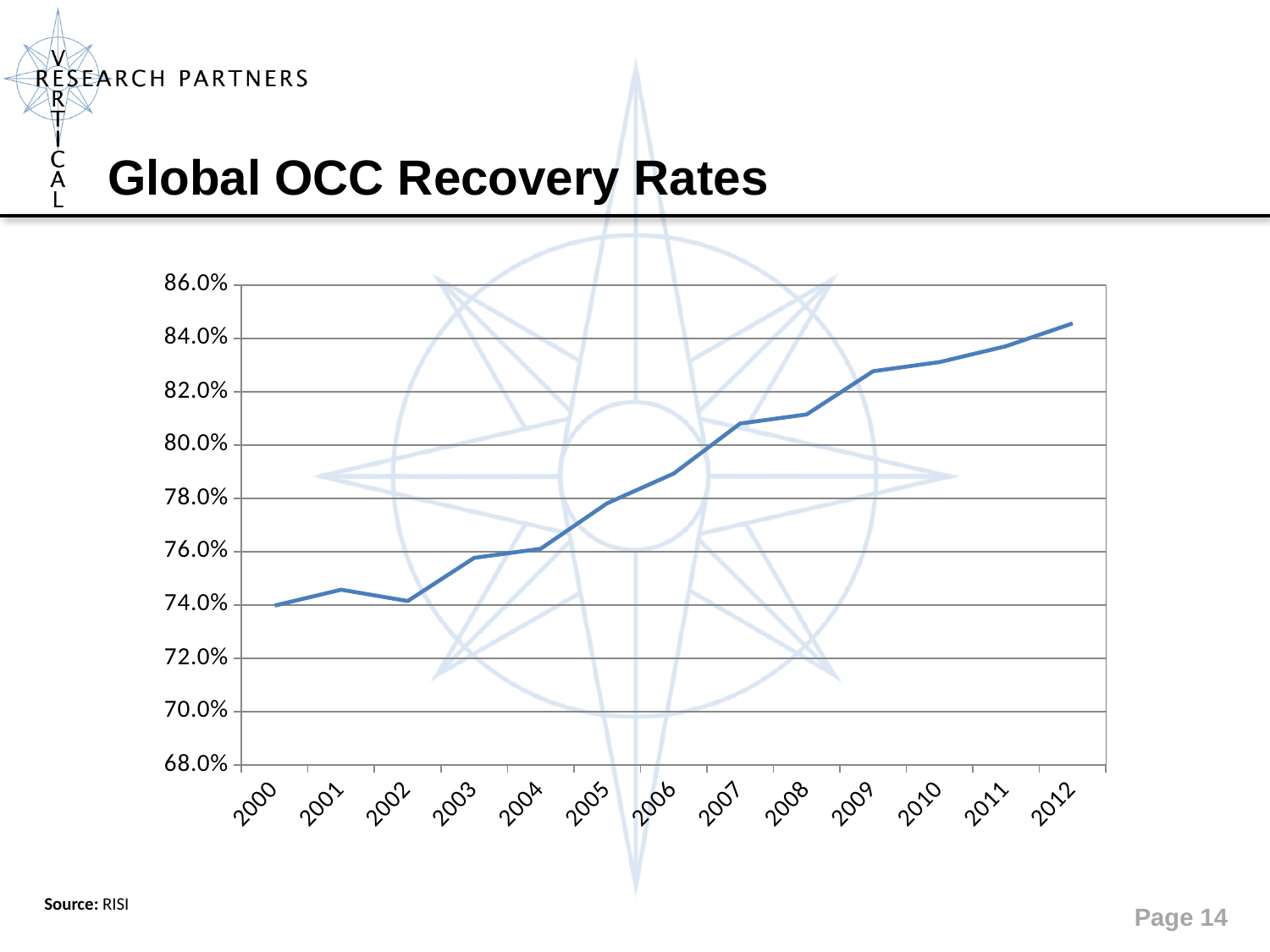
How many years are plotted on the x axis of the chart? 13 Do the recovery rates generally rise or fall from 2000 to 2012? rise Which year has the highest recovery rate? 2012 Is the value for 2007 greater or less than 80.0%? greater Is the value for 2009 greater or less than 82.0%? greater Is the value for 2003 greater or less than 76.0%? less What source is cited for the chart data? RISI What is the title of the chart? Global OCC Recovery Rates Which is larger, the value for 2009 or the value for 2008? 2009 What kind of chart is shown on the slide? line chart